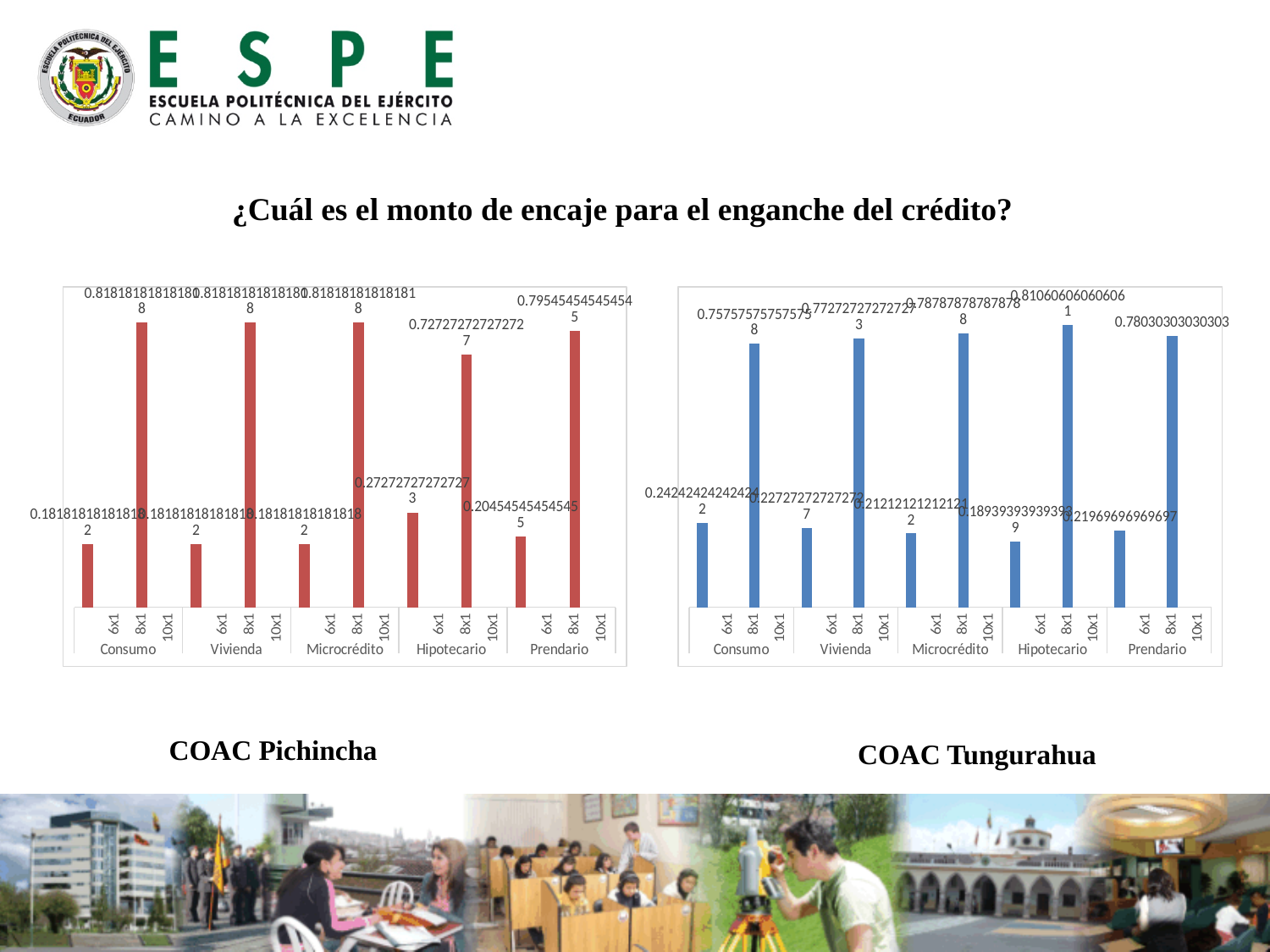
In the COAC Pichincha chart, what is the value for Hipotecario 8x1? 0.727272727272727 In the COAC Tungurahua chart, what is the value for Hipotecario 8x1? 0.810606060606061 What kind of chart is the COAC Pichincha chart? bar chart In the COAC Pichincha chart, which is larger: Prendario 6x1 or Hipotecario 6x1? Hipotecario 6x1 In the COAC Pichincha chart, which sub-category (6x1, 8x1 or 10x1) has no visible bar in any credit category? 10x1 In the COAC Pichincha chart, what is the value for Hipotecario 6x1? 0.272727272727273 In the COAC Tungurahua chart, what is the value for Prendario 8x1? 0.78030303030303 What colour are the bars in the COAC Tungurahua chart? blue In the COAC Pichincha chart, which is larger: Consumo 8x1 or Hipotecario 8x1? Consumo 8x1 What colour are the bars in the COAC Pichincha chart? red How many credit categories are shown along the x axis of the COAC Tungurahua chart? 5 In the COAC Tungurahua chart, which is larger: Consumo 6x1 or Hipotecario 6x1? Consumo 6x1